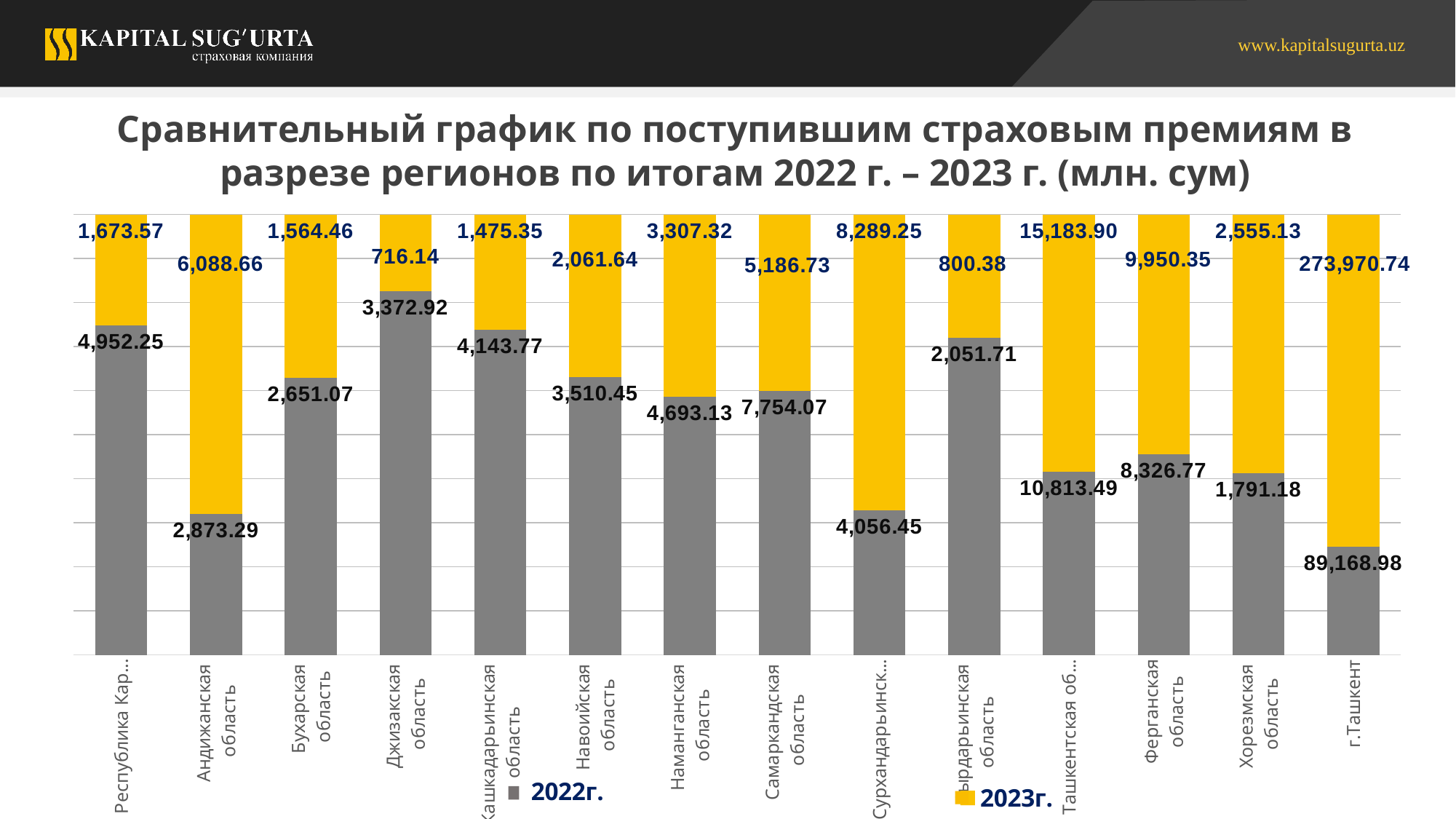
Which region has the lowest 2022 value? Хорезмская область What kind of chart is shown on the slide? Stacked bar chart For Навоийская область, which is larger: the 2022 value or the 2023 value? 2022 Which region has the lowest 2023 value? Джизакская область What is the 2023 value for Ферганская область? 9,950.35 How many series does the legend list? 2 What is the total of the 2022 and 2023 values for Хорезмская область? 4,346.31 What is the difference between the 2023 and 2022 values for Андижанская область? 3,215.37 What is the 2023 value for Сырдарьинская область? 800.38 What is the 2022 value for Самаркандская область? 7,754.07 How many regions are shown on the x axis? 14 Which region has the highest 2023 value? г.Ташкент